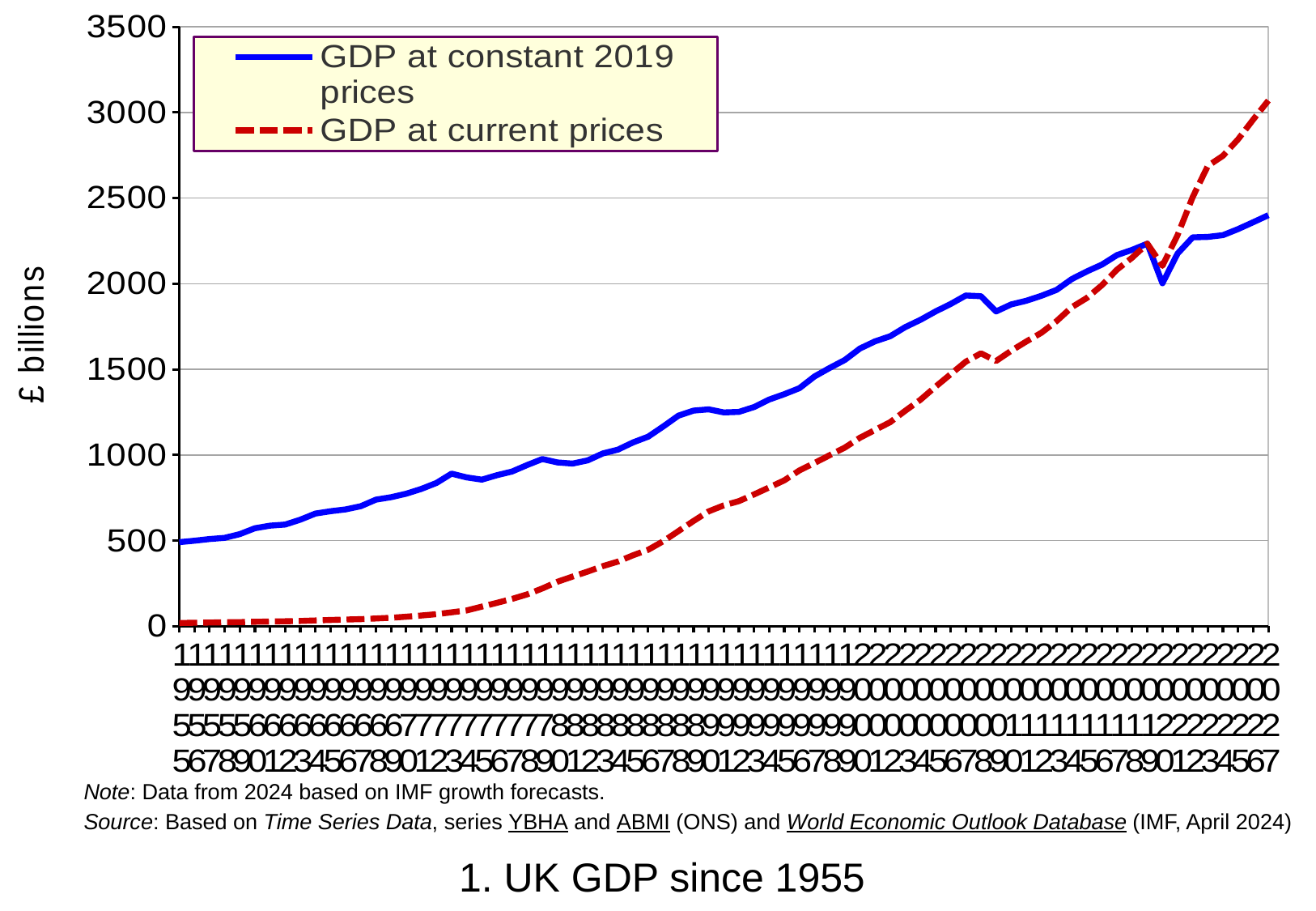
Overall, does GDP at current prices rise or fall from 1955 to 2027? Rise In 2027, which series has the higher value: GDP at constant 2019 prices or GDP at current prices? GDP at current prices What is the label on the vertical axis? £ billions Is the value for GDP at current prices in 2027 greater or less than 2500? greater Is the value for GDP at current prices in 1990 greater or less than 1000? less How many series does the legend list? 2 What is the title of the chart? 1. UK GDP since 1955 Is the value for GDP at constant 2019 prices in 1990 greater or less than 1000? greater In 1980, which series has the higher value: GDP at constant 2019 prices or GDP at current prices? GDP at constant 2019 prices What kind of chart is shown on the slide? Line chart